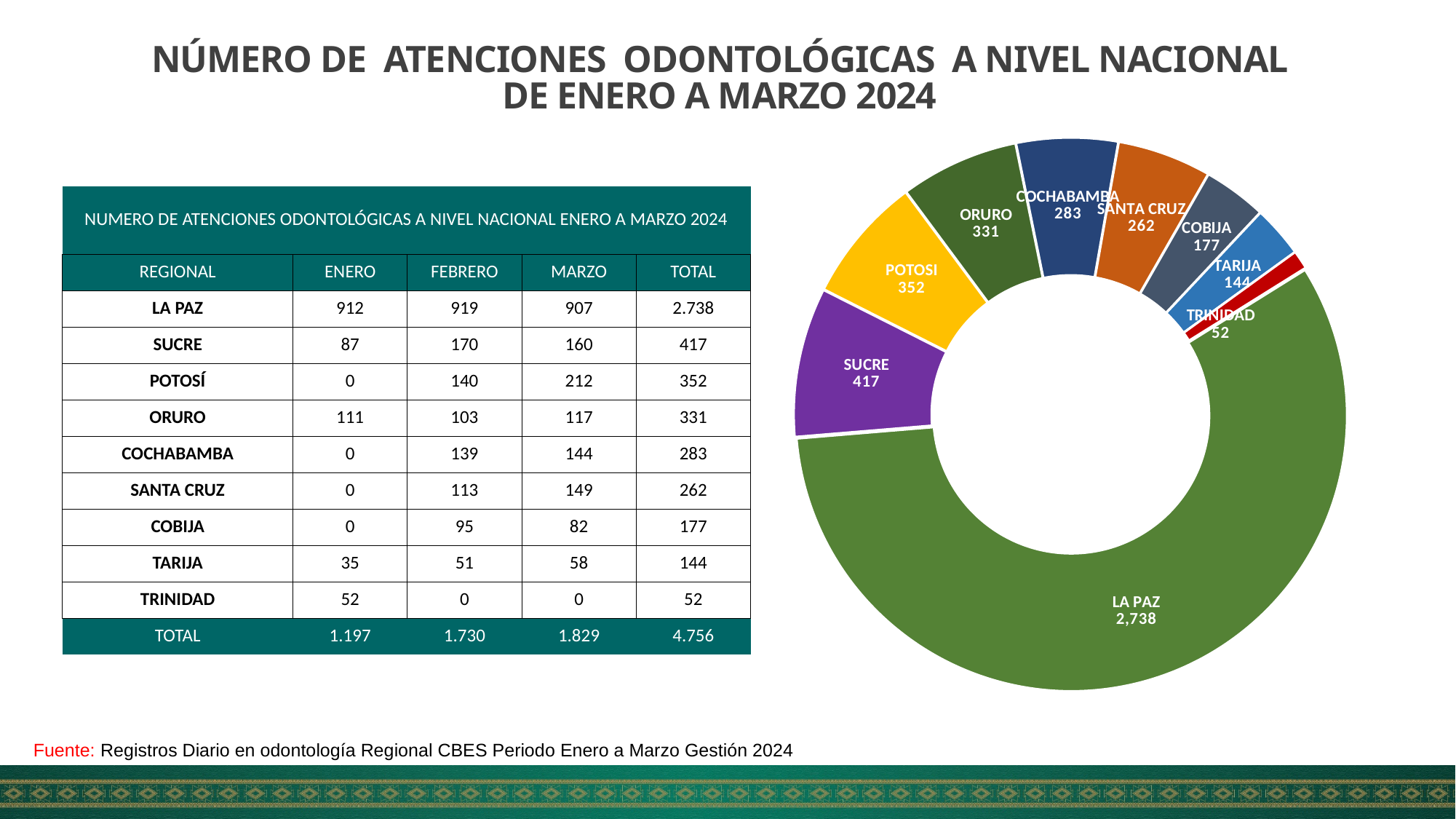
Which regional has the smallest slice in the doughnut chart? TRINIDAD In the doughnut chart, what is the difference between the values for LA PAZ and SUCRE? 2,321 What kind of chart is shown on the right of the slide? Doughnut (pie) chart In the doughnut chart, what is the difference between the values for POTOSI and ORURO? 21 In the doughnut chart, what is the value for COBIJA? 177 In the doughnut chart, what is the value for SUCRE? 417 In the doughnut chart, what colour is the LA PAZ slice? Green In the doughnut chart, which is larger, the value for COCHABAMBA or the value for SANTA CRUZ? COCHABAMBA Which regional has the largest slice in the doughnut chart? LA PAZ In the doughnut chart, what is the value for TRINIDAD? 52 In the doughnut chart, what is the value for LA PAZ? 2,738 How many regional slices does the doughnut chart show? 9